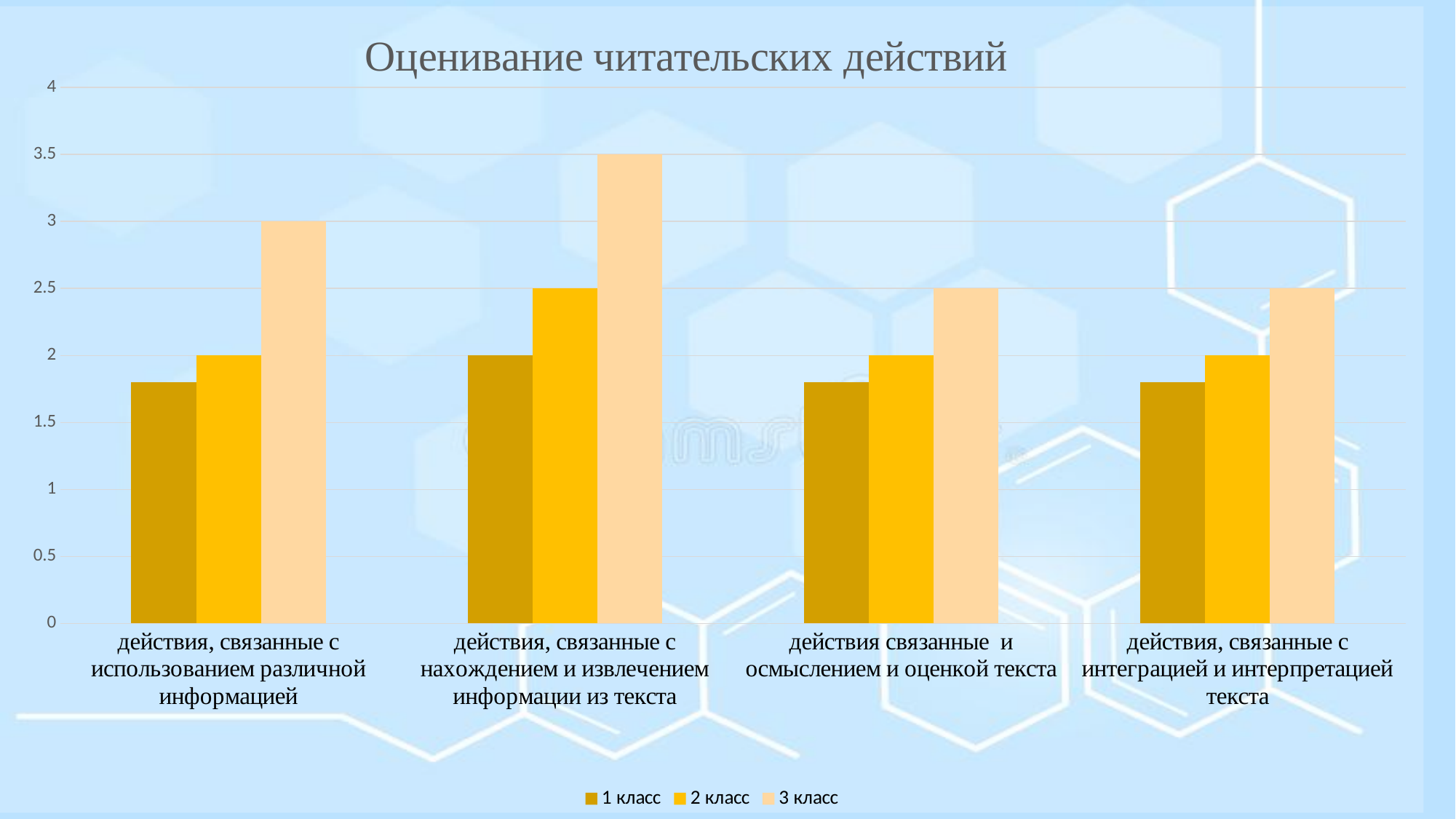
What is the value for 3 класс in the category 'действия, связанные с использованием различной информацией'? 3 How many series does the legend list? 3 In which category does 3 класс have its highest value? действия, связанные с нахождением и извлечением информации из текста How many categories are shown along the x axis? 4 Which series has the larger value in the category 'действия, связанные с использованием различной информацией': 2 класс or 3 класс? 3 класс Is the value for 1 класс in the category 'действия, связанные с интеграцией и интерпретацией текста' greater or less than 2? less What is the value for 2 класс in the category 'действия, связанные с нахождением и извлечением информации из текста'? 2.5 What is the value for 3 класс in the category 'действия, связанные с нахождением и извлечением информации из текста'? 3.5 What type of chart is shown on the slide? bar chart What is the value for 2 класс in the category 'действия связанные и осмыслением и оценкой текста'? 2 What is the title of the chart? Оценивание читательских действий What is the difference between the 3 класс and 1 класс values in the category 'действия, связанные с нахождением и извлечением информации из текста'? 1.5